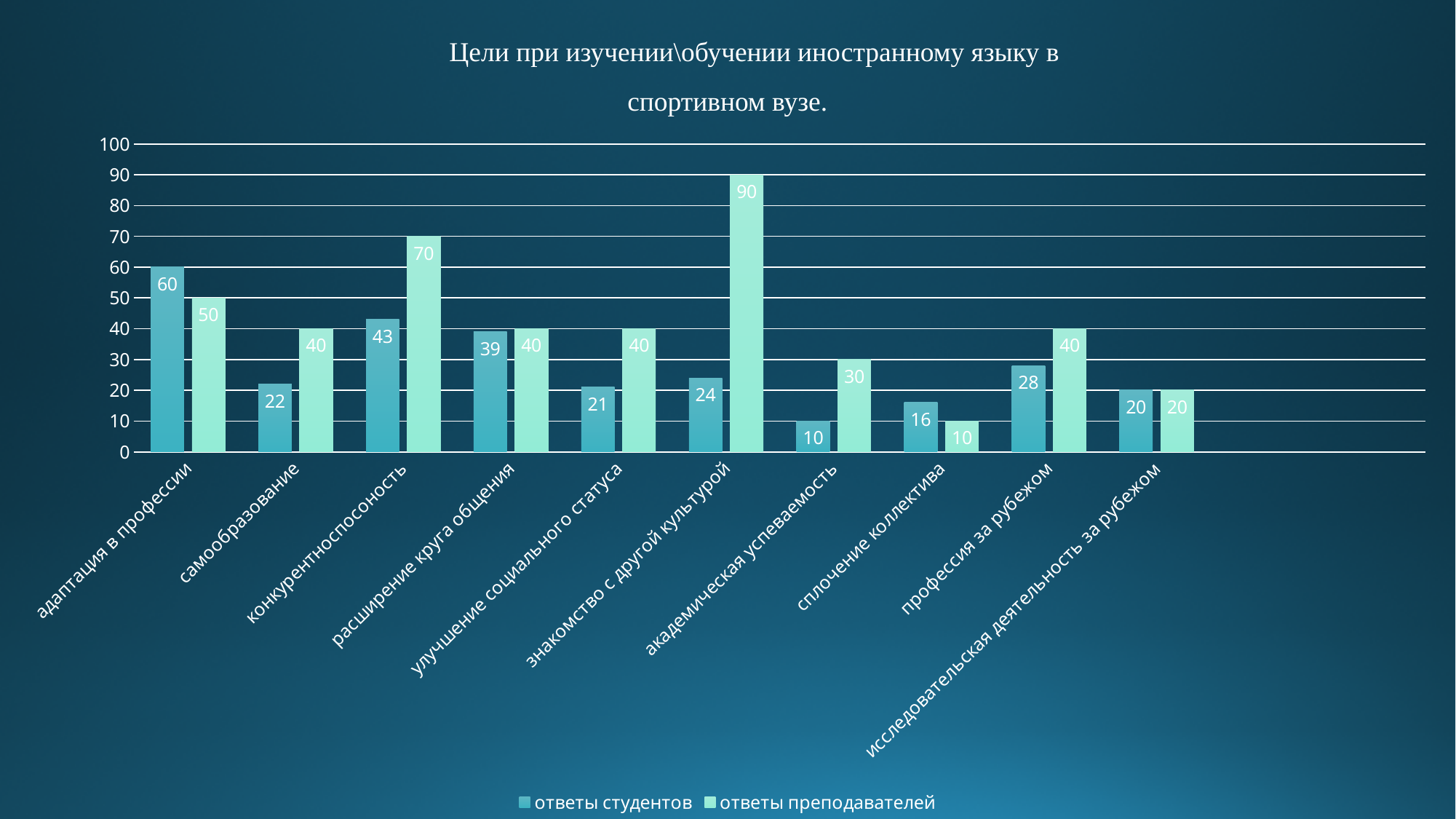
What is the value for 'ответы студентов' in the category 'конкурентноспособность'? 43 For 'сплочение коллектива', which series has the larger value, 'ответы студентов' or 'ответы преподавателей'? ответы студентов Which category has the lowest value for 'ответы студентов'? академическая успеваемость What is the difference between 'ответы преподавателей' and 'ответы студентов' for 'знакомство с другой культурой'? 66 What is the value for 'ответы студентов' in the category 'адаптация в профессии'? 60 How many series does the legend list? 2 What type of chart is shown on the slide? bar chart What is the title of the chart? Цели при изучении\обучении иностранному языку в спортивном вузе. Which category has the highest value for 'ответы преподавателей'? знакомство с другой культурой What is the value for 'ответы преподавателей' in the category 'исследовательская деятельность за рубежом'? 20 How many categories are shown on the x axis? 10 What is the value for 'ответы преподавателей' in the category 'знакомство с другой культурой'? 90